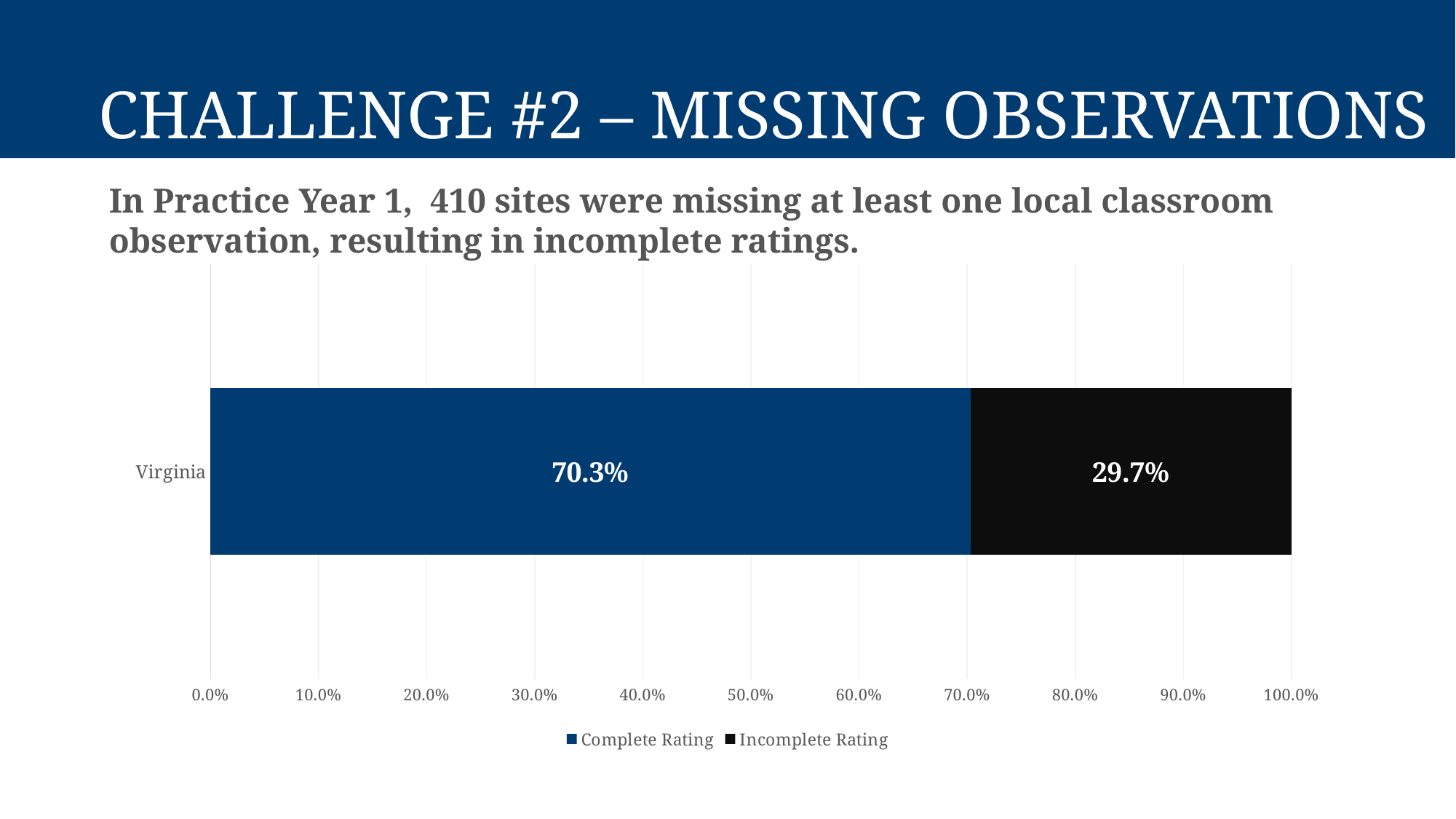
What percentage of Virginia sites had a Complete Rating? 70.3% Which series is shown in black on the chart? Incomplete Rating What is the total of the stacked bar for Virginia? 100.0% What percentage of Virginia sites had an Incomplete Rating? 29.7% How many categories are shown on the chart? 1 Is the Incomplete Rating value for Virginia greater or less than 40.0%? less What is the difference in percentage points between the Complete Rating and Incomplete Rating shares for Virginia? 40.6 How many series does the legend list? 2 Is the Complete Rating value for Virginia greater or less than 50.0%? greater What kind of chart is shown on the slide? Stacked bar chart What is the maximum value shown on the x axis? 100.0% Which series has the larger share for Virginia, Complete Rating or Incomplete Rating? Complete Rating